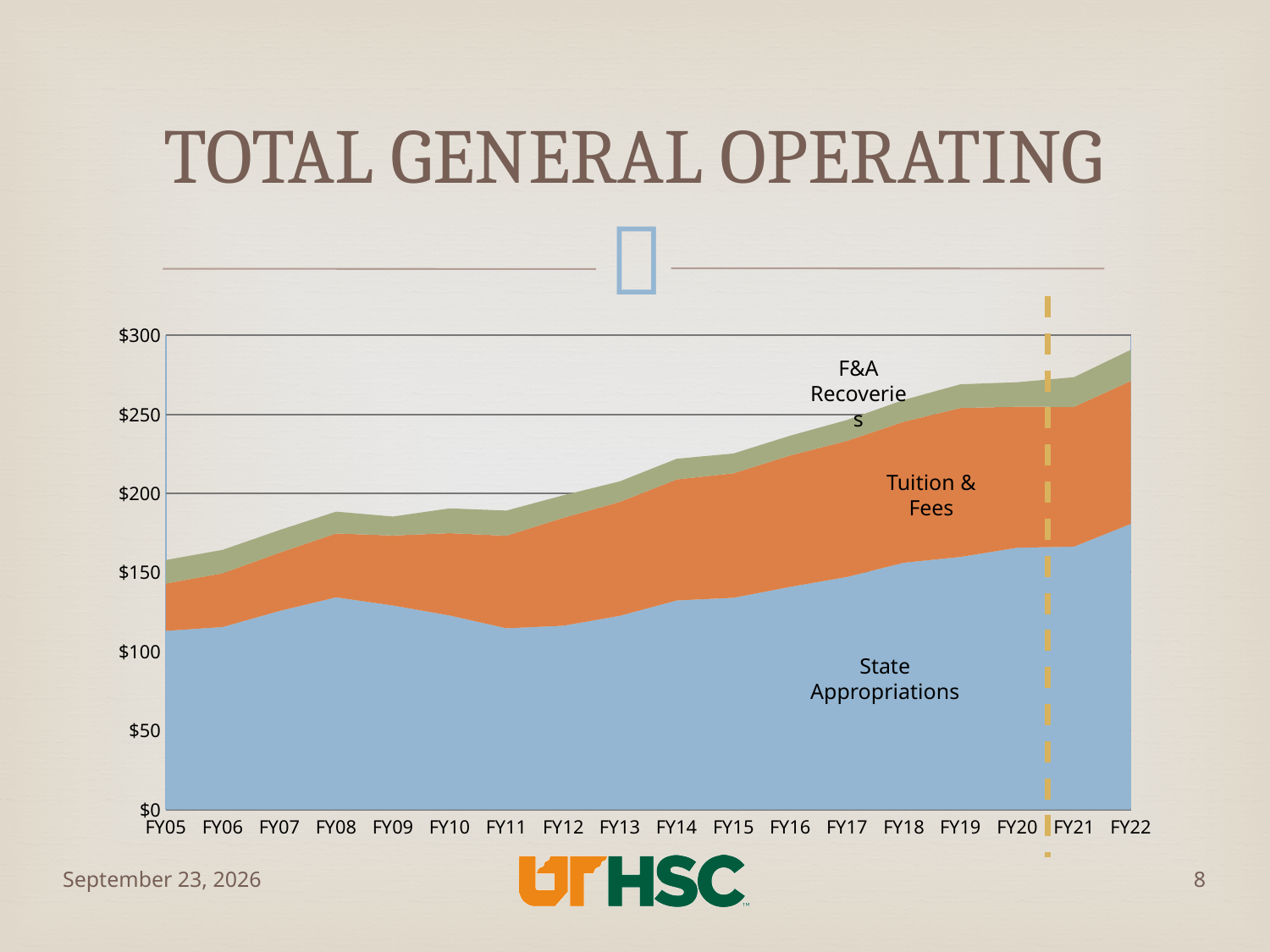
Is the total general operating value in FY19 greater or less than $250? greater Does the total general operating value rise or fall overall from FY05 to FY22? Rise Is the total general operating value in FY22 greater or less than $250? greater How many fiscal years are shown along the x axis? 18 Is the value for State Appropriations in FY22 greater or less than $150? greater What is the title of the chart on the slide? TOTAL GENERAL OPERATING How many series are labelled in the chart? 3 Does the State Appropriations value rise or fall from FY08 to FY11? Fall Which series forms the bottom layer of the stacked area chart? State Appropriations What kind of chart is shown on the slide? Stacked area chart